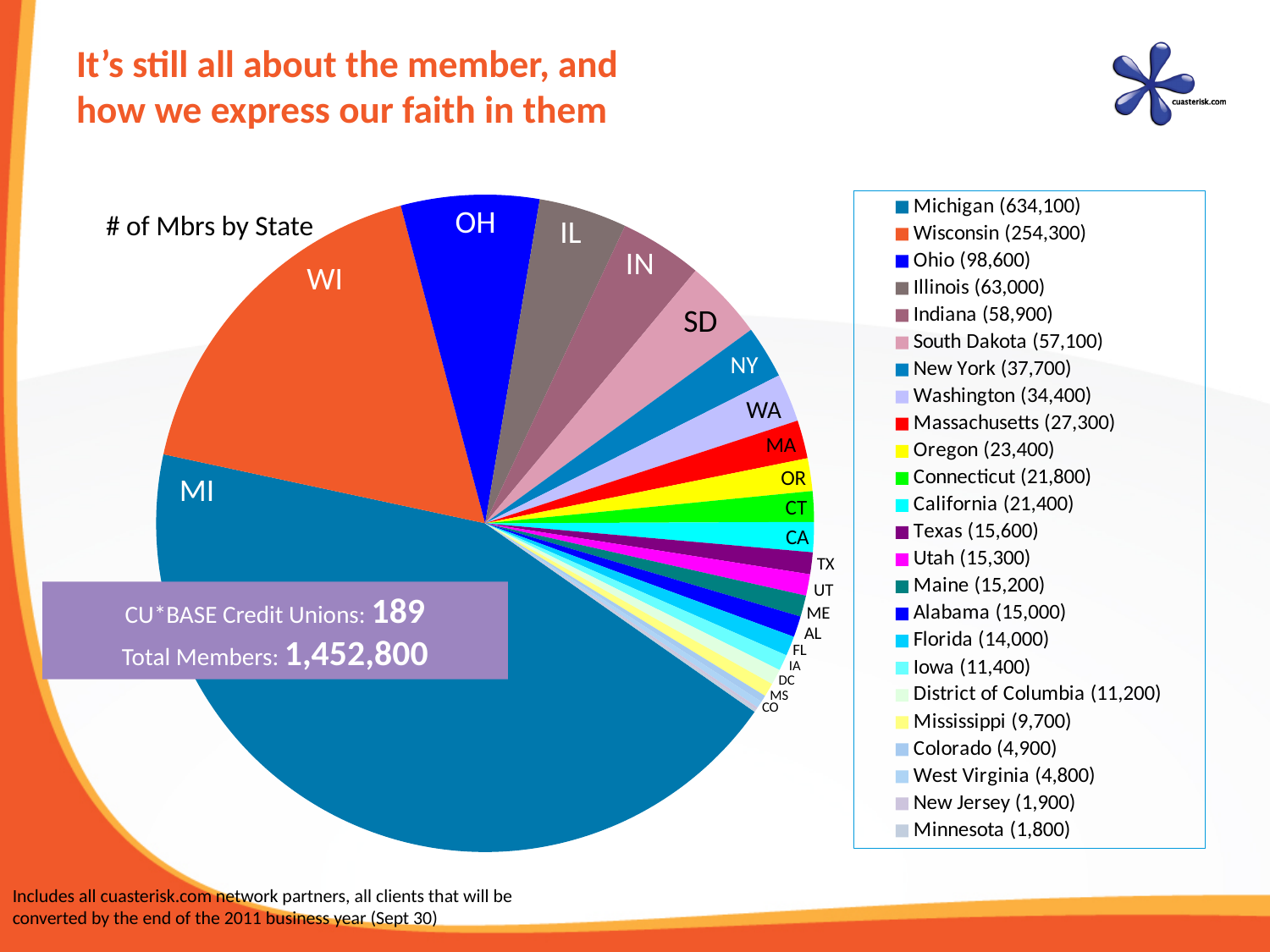
What is the number of members for Wisconsin? 254,300 How many states/regions are listed in the chart legend? 24 What is the number of members for Texas? 15,600 What type of chart is shown on the slide? Pie chart What is the difference in members between Wisconsin and Ohio? 155,700 Which state has the largest number of members? Michigan Which state has the smallest number of members? Minnesota Which has more members, New York or Washington? New York What is the number of members for District of Columbia? 11,200 How many members does Michigan have according to the legend? 634,100 What is the difference in members between Illinois and Indiana? 4,100 What is the title of the chart? # of Mbrs by State